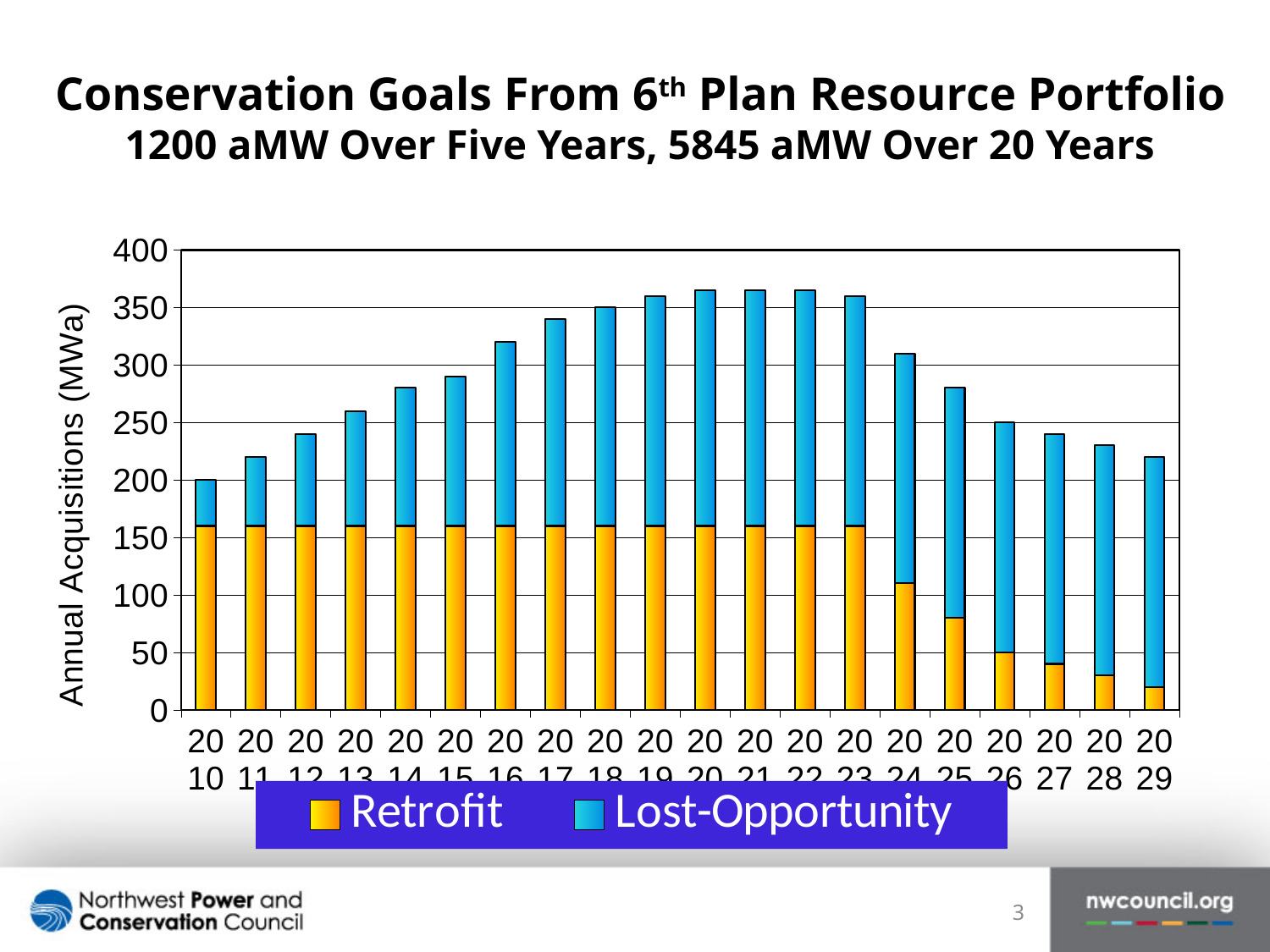
Is the total annual acquisitions for 2021 greater or less than 350? greater Which year has the larger total annual acquisitions, 2018 or 2029? 2018 What are the two series named in the legend? Retrofit and Lost-Opportunity Which year has the smallest Retrofit value? 2029 Which year has the lowest total annual acquisitions? 2010 What kind of chart is shown on the slide? bar chart How many series does the legend list? 2 What is the label of the vertical axis? Annual Acquisitions (MWa) Is the Retrofit value for 2025 greater or less than 100? less How many years are shown along the x axis? 20 Do the total annual acquisitions rise or fall from 2010 to 2020? rise Is the total annual acquisitions for 2016 greater or less than 300? greater